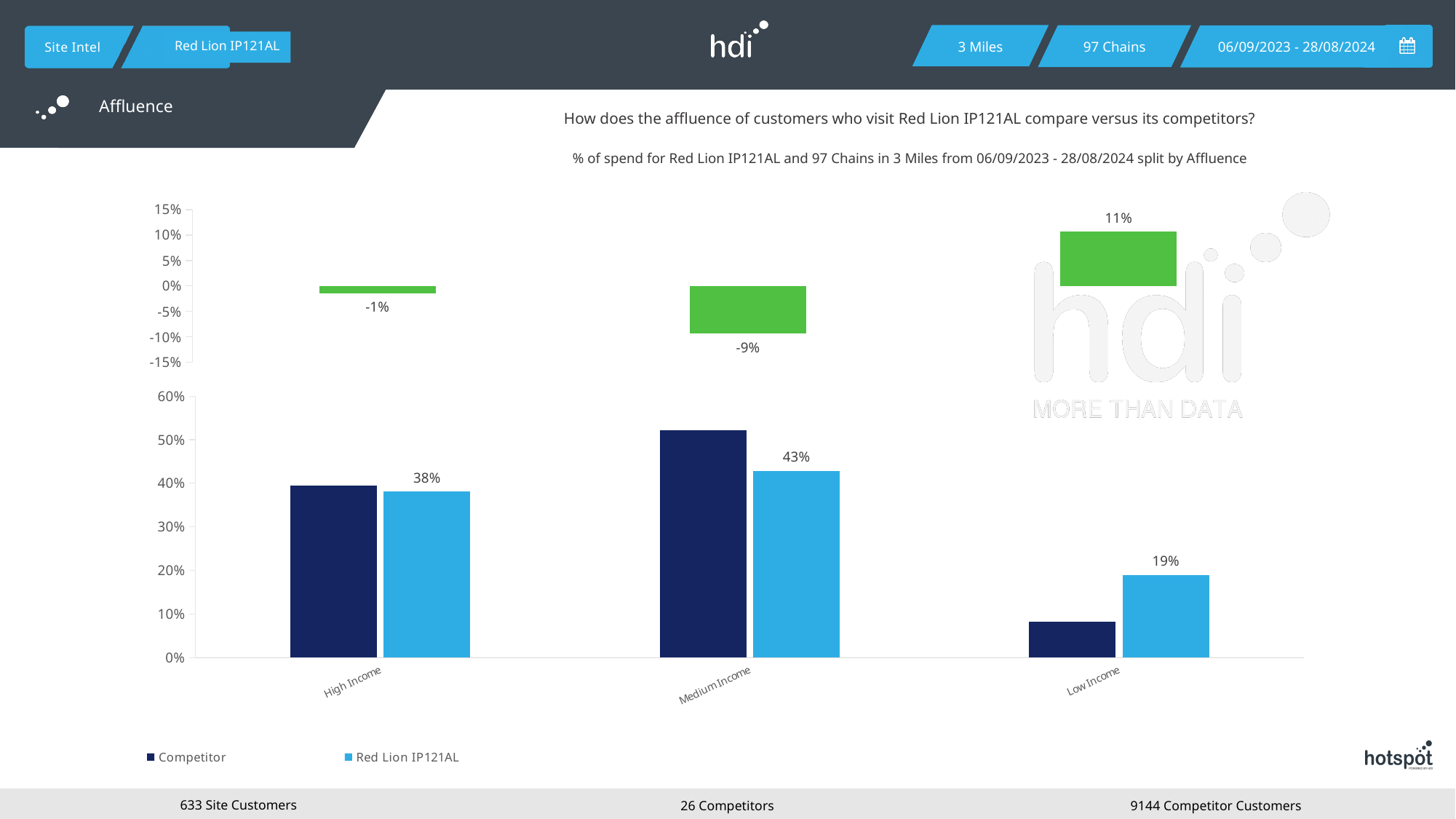
In the bottom bar chart, what is the value for Red Lion IP121AL in the High Income category? 38% In the top green bar chart, which category has the highest value? Low Income In the top green bar chart, what is the value shown for the Low Income category? 11% In the bottom bar chart, is the Competitor value for Medium Income greater or less than 50%? greater In the top green bar chart, which category has the lowest value? Medium Income In the bottom bar chart, which category has the highest Red Lion IP121AL value? Medium Income In the bottom bar chart, what is the value for Red Lion IP121AL in the Medium Income category? 43% In the bottom bar chart, what is the difference between the Red Lion IP121AL values for Medium Income and Low Income? 24% In the bottom bar chart, what is the value for Red Lion IP121AL in the Low Income category? 19% In the top green bar chart, what is the value shown for the Medium Income category? -9% In the bottom bar chart, is the Competitor value for Low Income greater or less than 10%? less How many series does the legend of the bottom bar chart list? 2